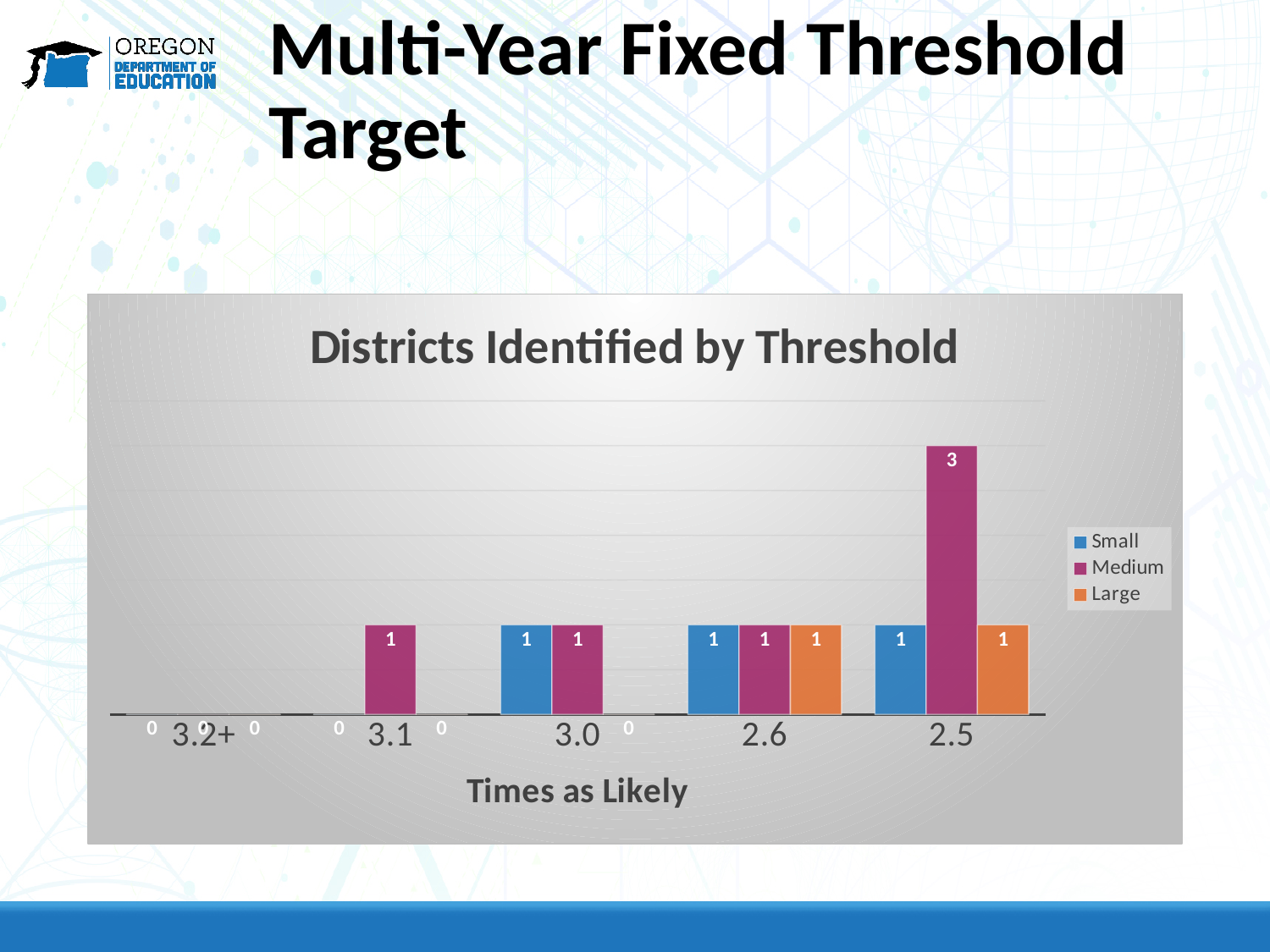
What is the value for Large at the 2.6 threshold? 1 Which is larger at the 3.0 threshold, the Small value or the Large value? Small What is the value for Medium at the 2.5 threshold? 3 At which threshold is the Medium value highest? 2.5 What is the value for Small at the 3.1 threshold? 0 What is the difference between the Medium value at 2.5 and the Medium value at 2.6? 2 What is the value for Large at the 3.2+ threshold? 0 What type of chart is shown on the slide? bar chart How many series does the legend list? 3 How many categories are shown on the x axis? 5 What is the x axis title of the chart? Times as Likely What is the title of the chart? Districts Identified by Threshold